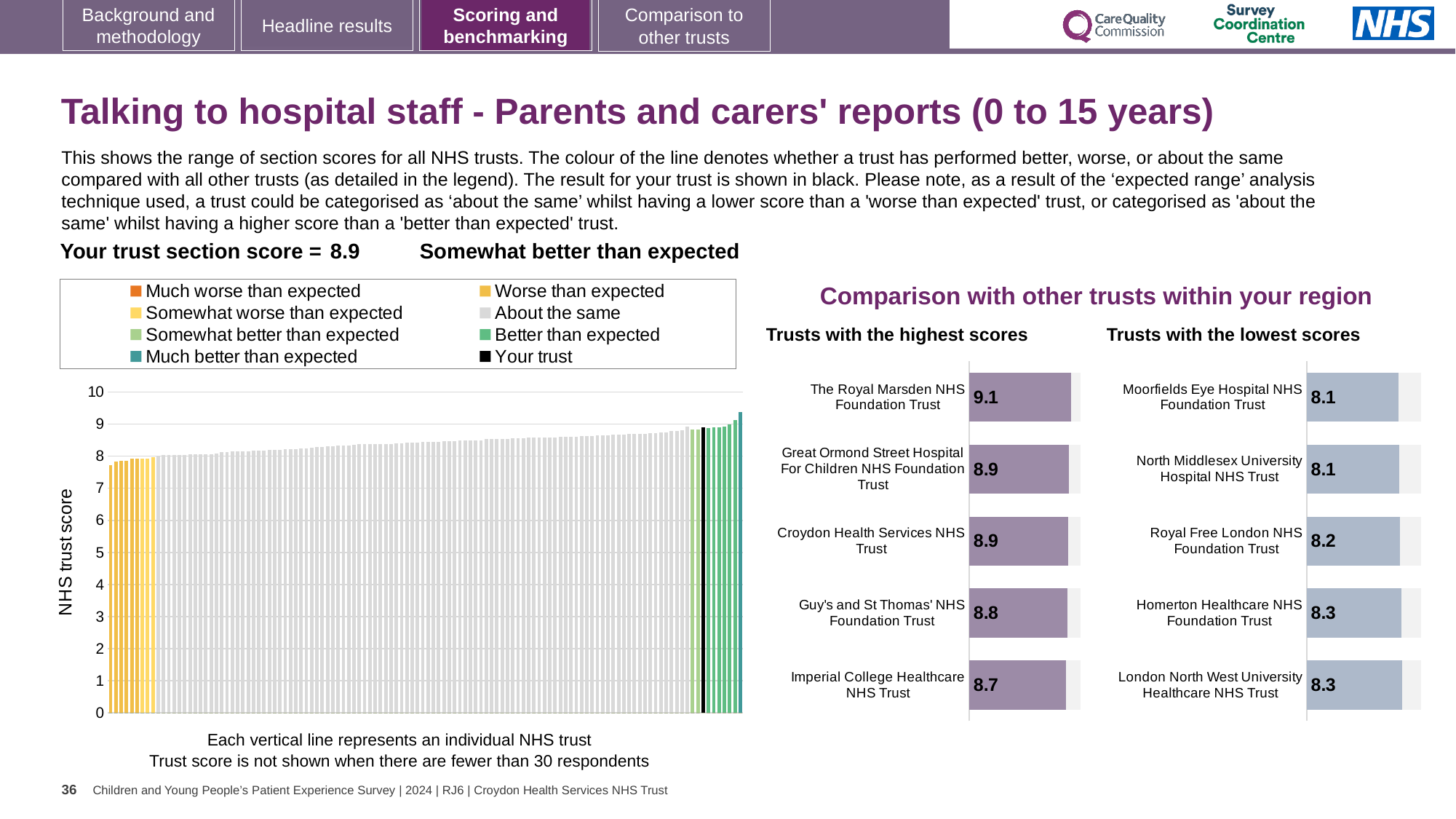
In the 'Trusts with the highest scores' chart, what is the score for Imperial College Healthcare NHS Trust? 8.7 In the left-hand chart of NHS trust scores, is the value of the leftmost bar greater or less than 8? less In the 'Trusts with the highest scores' chart, which trust has the highest score? The Royal Marsden NHS Foundation Trust How many trusts are shown in the 'Trusts with the highest scores' chart? 5 In the 'Trusts with the lowest scores' chart, which trust has the highest score shown, Homerton Healthcare NHS Foundation Trust or Royal Free London NHS Foundation Trust? Homerton Healthcare NHS Foundation Trust In the 'Trusts with the highest scores' chart, what is the score for The Royal Marsden NHS Foundation Trust? 9.1 In the 'Trusts with the lowest scores' chart, what is the difference between the scores of London North West University Healthcare NHS Trust and Moorfields Eye Hospital NHS Foundation Trust? 0.2 In the 'Trusts with the highest scores' chart, what is the difference between the scores of The Royal Marsden NHS Foundation Trust and Imperial College Healthcare NHS Trust? 0.4 In the 'Trusts with the lowest scores' chart, what is the score for Royal Free London NHS Foundation Trust? 8.2 In the left-hand chart of NHS trust scores, do the values rise or fall from left to right? rise How many entries does the legend of the left-hand chart list? 8 In the left-hand chart of NHS trust scores, what is the section score for your trust? 8.9